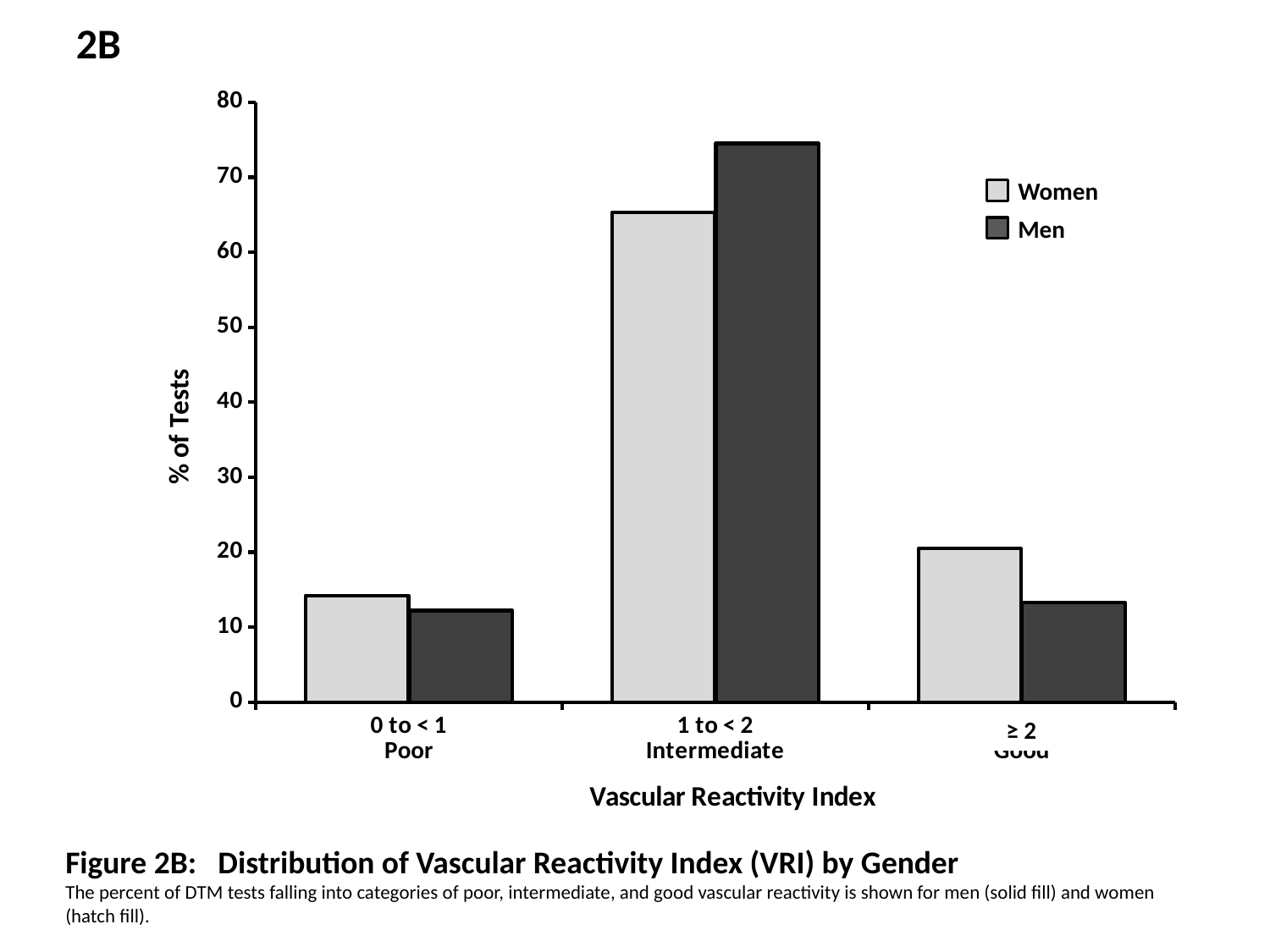
Is the value for Women in the 0 to < 1 Poor category greater or less than 20? less Which category has the lowest value for Women? 0 to < 1 Poor Is the value for Women in the 1 to < 2 Intermediate category greater or less than 70? less How many Vascular Reactivity Index categories are shown on the x axis? 3 How many series does the legend list? 2 What is the label of the y axis? % of Tests Which category has the highest value for Women? 1 to < 2 Intermediate Which category has the highest value for Men? 1 to < 2 Intermediate Is the value for Men in the 1 to < 2 Intermediate category greater or less than 70? greater In the ≥ 2 Good category, which is larger, the value for Women or for Men? Women In the 1 to < 2 Intermediate category, which is larger, the value for Women or for Men? Men What kind of chart is shown on the slide? bar chart